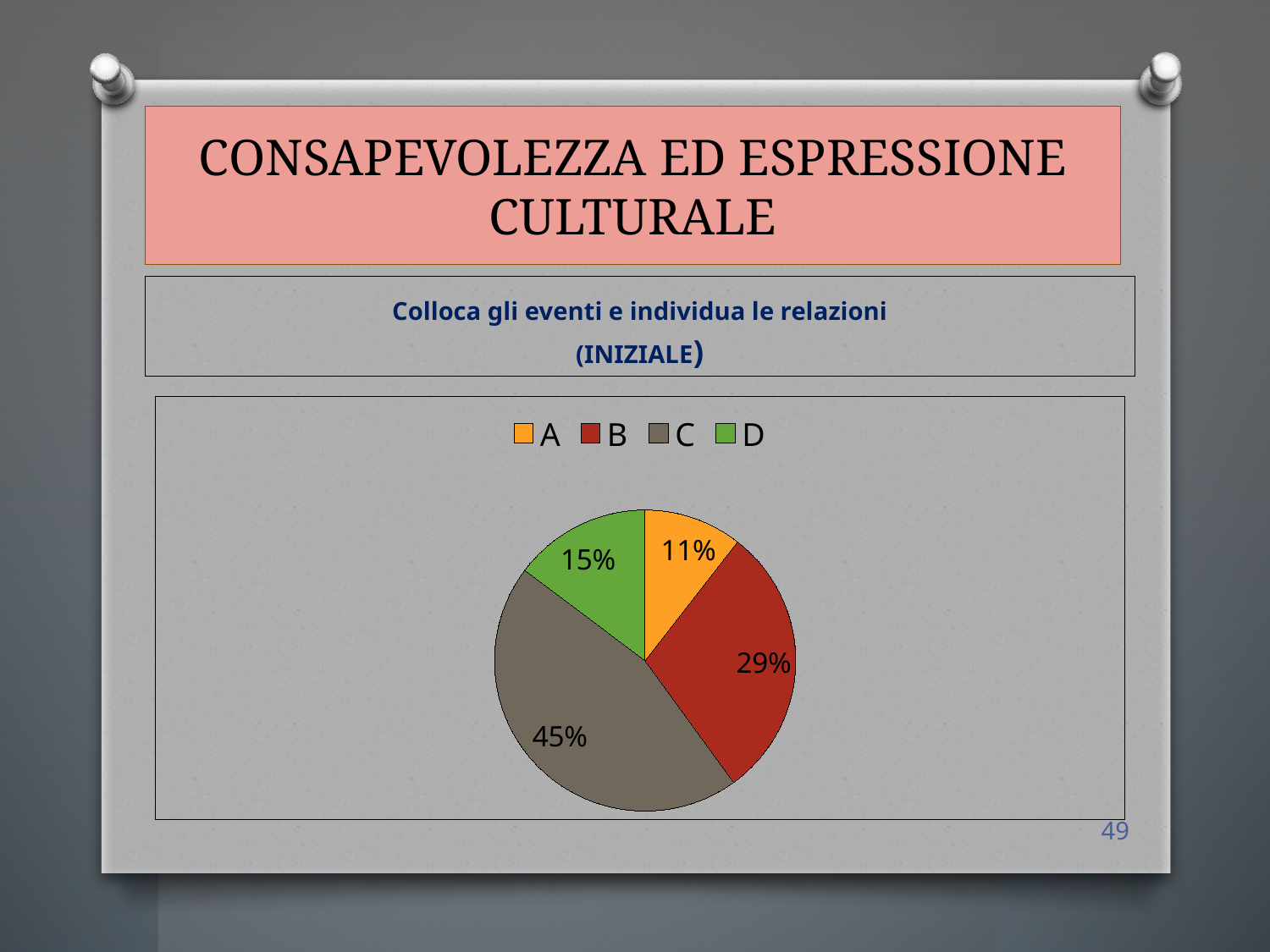
What kind of chart is shown on the slide? pie chart What percentage does slice C represent in the pie chart? 45% Which category has the largest slice of the pie chart? C What is the difference in percentage points between slice C and slice B? 16 Which category has the smallest slice of the pie chart? A What percentage does slice D represent in the pie chart? 15% What percentage does slice B represent in the pie chart? 29% How many slices does the pie chart have? 4 What colour is the slice for category C in the pie chart? grey Which slice is larger, B or D? B How many entries does the legend list? 4 What percentage does slice A represent in the pie chart? 11%